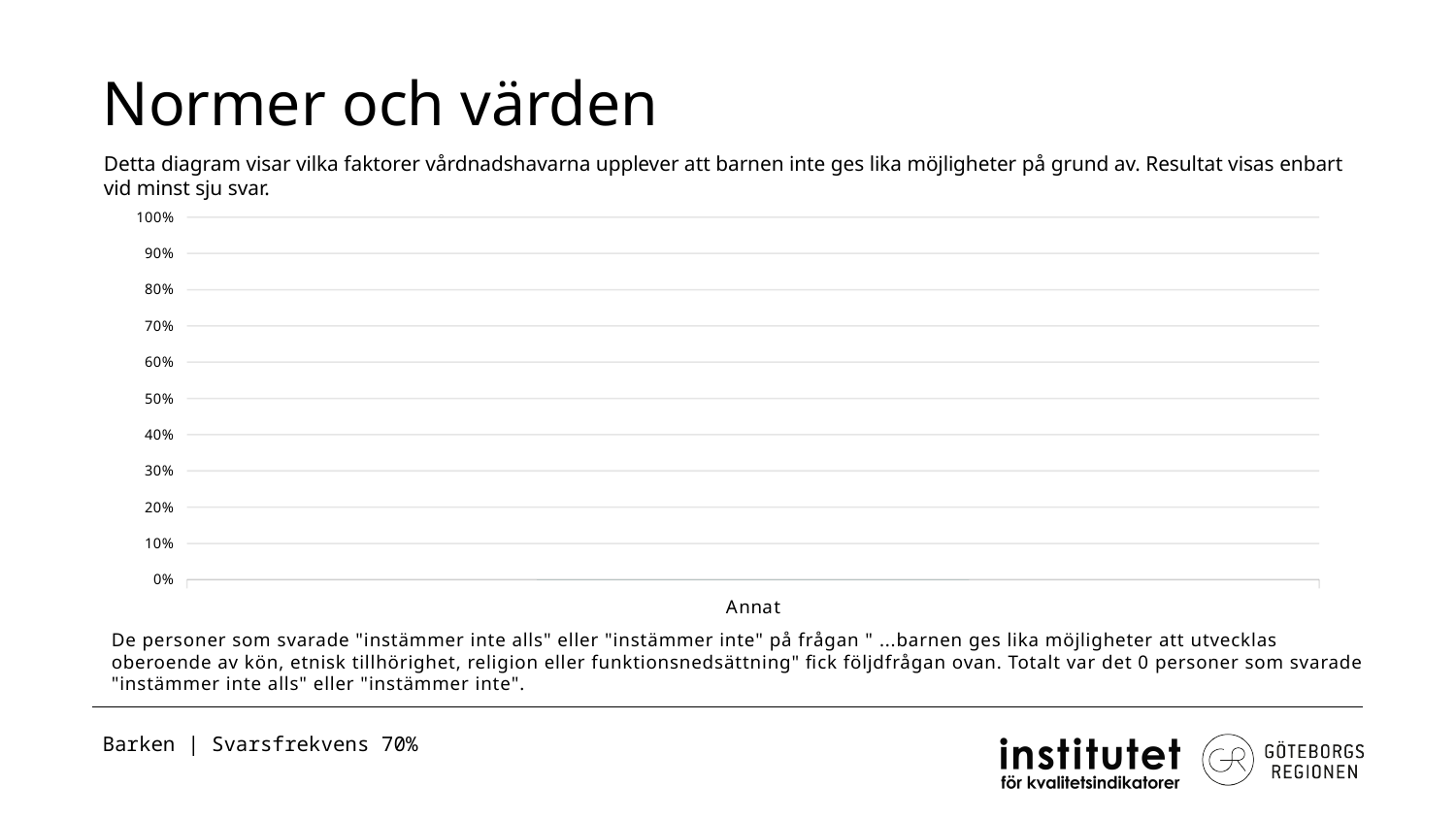
What is the highest value shown on the y axis of the chart? 100% Does the chart display a legend? No What is the label of the only category on the x axis of the chart? Annat How many categories are shown on the x axis of the chart? 1